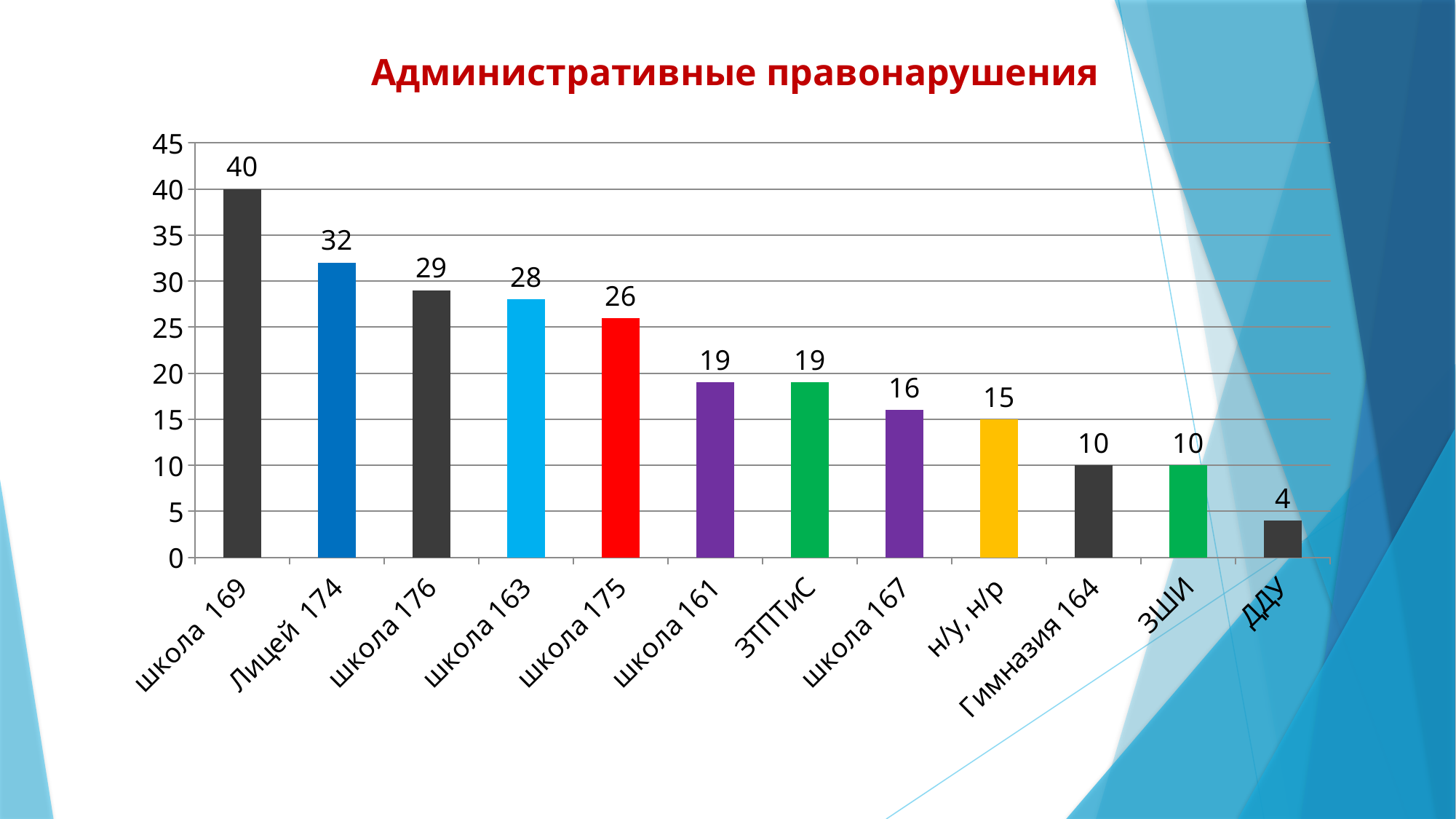
What is the value for ЗТПТиС? 19 What is the value for школа 169? 40 What is the difference between the values for школа 175 and школа 167? 10 Which is larger, the value for школа 176 or the value for школа 163? школа 176 Which category has the lowest value? ДДУ What is the value for ДДУ? 4 What is the value for Лицей 174? 32 How many categories are shown on the chart? 12 Which category has the highest value? школа 169 What is the difference between the values for школа 169 and Лицей 174? 8 What is the title of the chart? Административные правонарушения What kind of chart is shown on the slide? bar chart